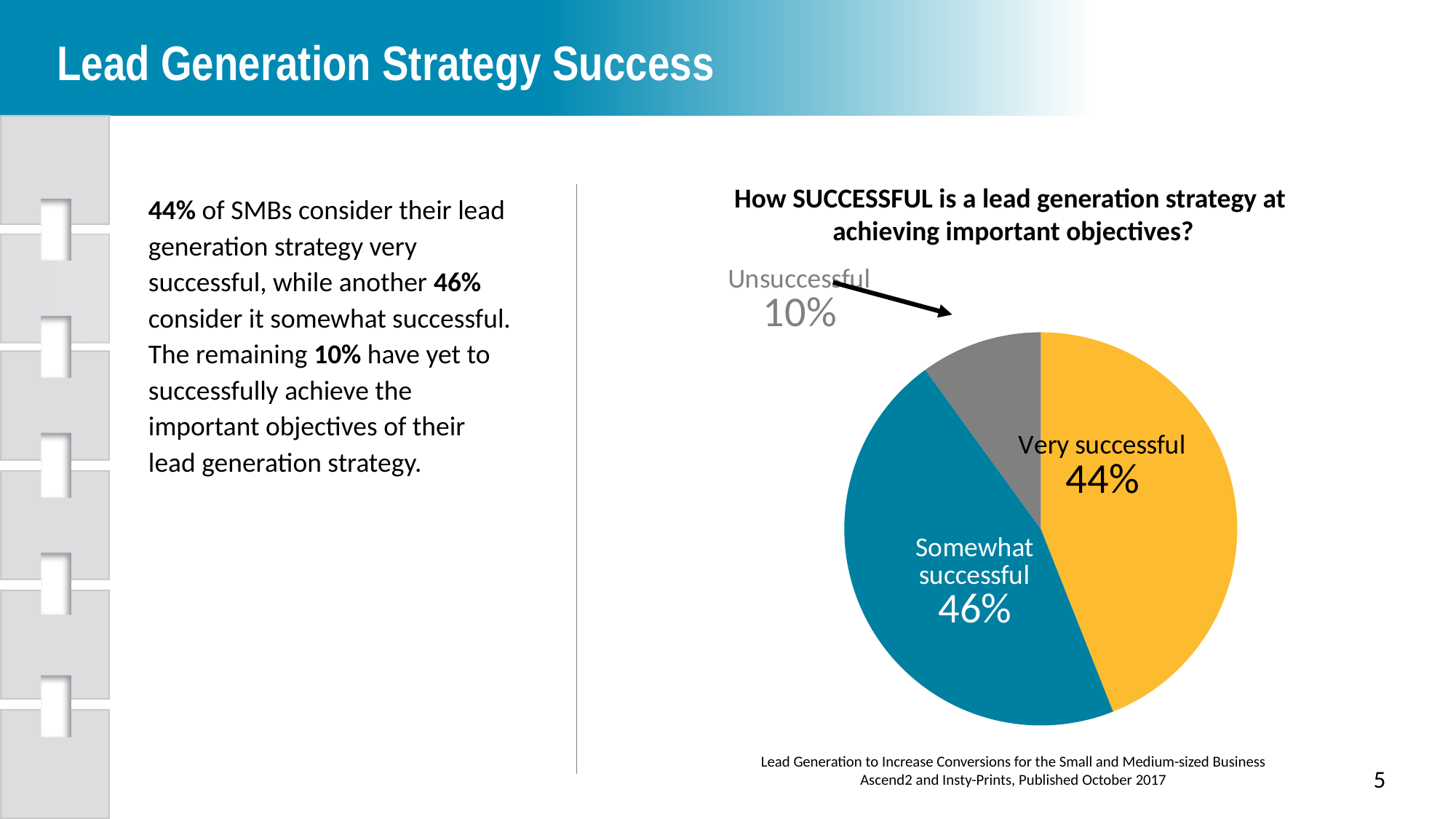
What percentage of the pie is labelled 'Very successful'? 44% What percentage of the pie is labelled 'Somewhat successful'? 46% Which slice of the pie is the largest? Somewhat successful Which is larger, the 'Very successful' slice or the 'Unsuccessful' slice? Very successful What percentage of the pie is labelled 'Unsuccessful'? 10% What is the difference in percentage points between the 'Very successful' and 'Unsuccessful' slices? 34 What is the difference in percentage points between the 'Somewhat successful' and 'Very successful' slices? 2 How many slices does the pie chart have? 3 What kind of chart is shown on the slide? pie chart What colour is the 'Somewhat successful' slice of the pie? teal blue What is the title of the pie chart? How SUCCESSFUL is a lead generation strategy at achieving important objectives? Which slice of the pie is the smallest? Unsuccessful